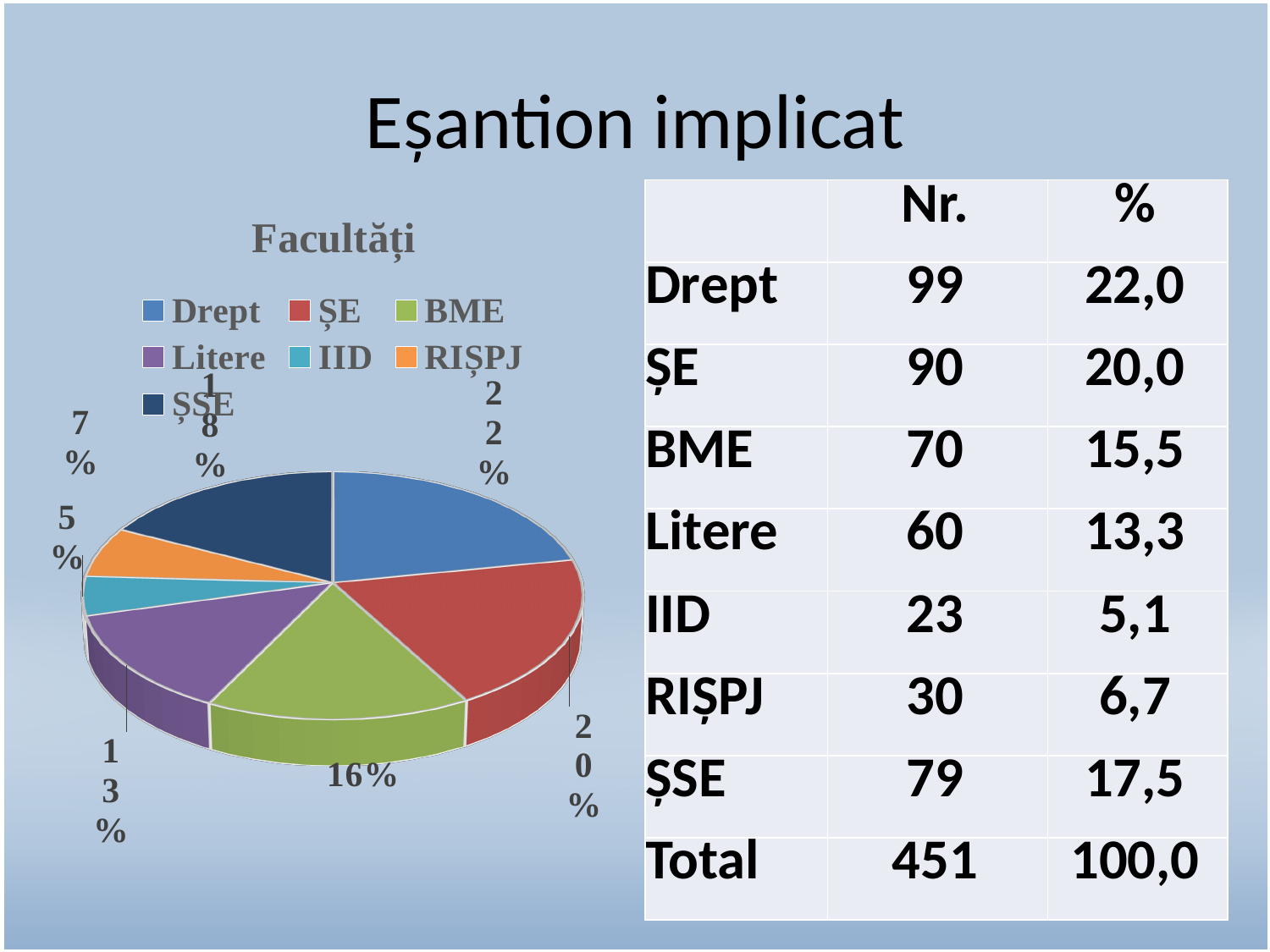
In the pie chart, which slice is larger: Litere or RIȘPJ? Litere What percentage does the pie chart show for BME? 16% How many slices does the pie chart have? 7 Which faculty has the smallest slice in the pie chart? IID In the pie chart, what is the difference in percentage points between ȘE and Litere? 7 What percentage does the pie chart show for IID? 5% What kind of chart is shown under the title "Facultăți"? pie chart How many entries does the legend of the pie chart list? 7 What percentage does the pie chart show for Drept? 22% Which faculty has the largest slice in the pie chart? Drept What is the title of the pie chart? Facultăți What percentage does the pie chart show for ȘSE? 18%